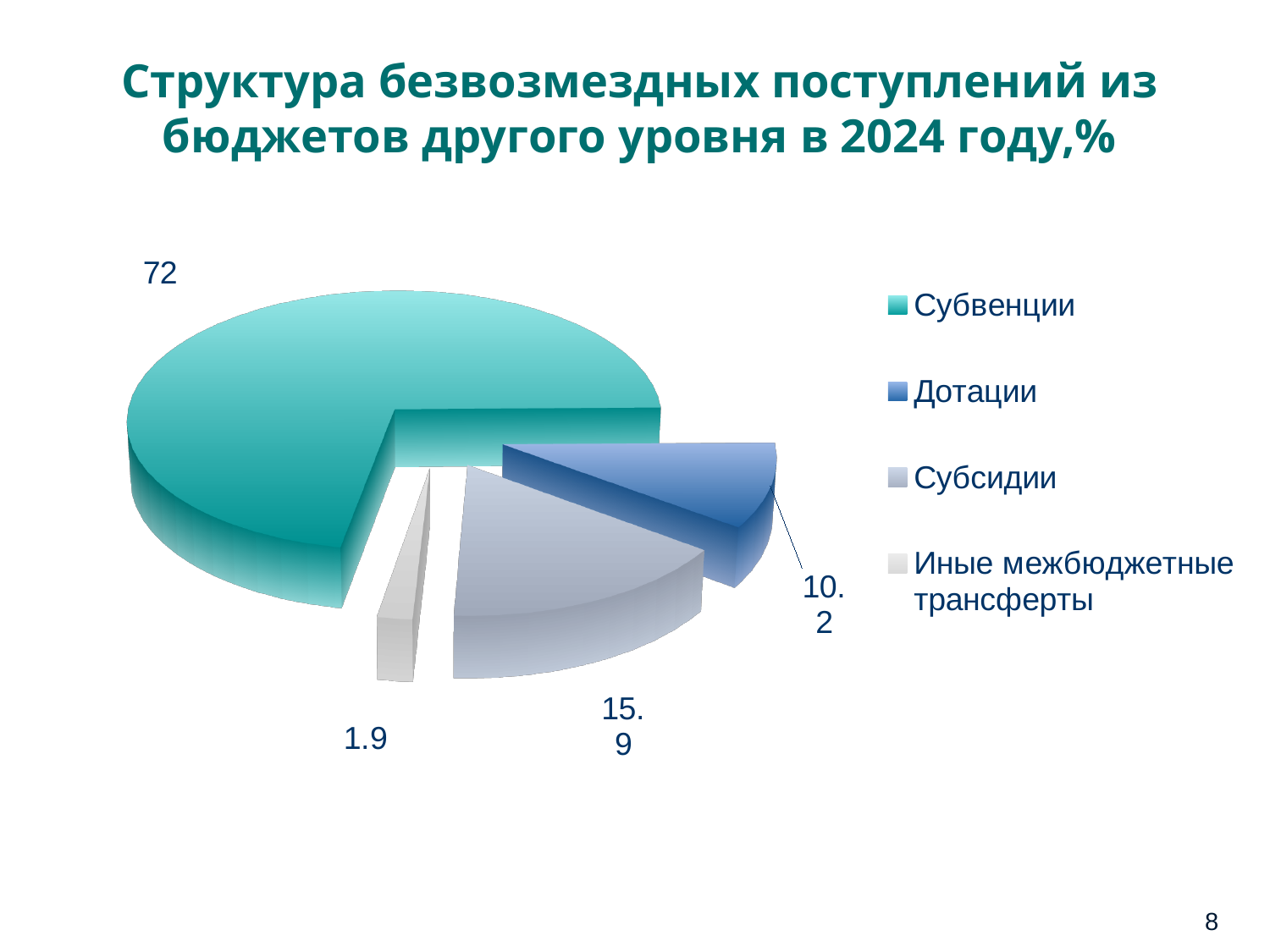
Which category has the largest slice? Субвенции Which category has the smallest slice? Иные межбюджетные трансферты How many slices does the pie chart have? 4 What is the value for Субсидии? 15.9 What is the value for Иные межбюджетные трансферты? 1.9 What is the title of the chart? Структура безвозмездных поступлений из бюджетов другого уровня в 2024 году,% What is the value for Дотации? 10.2 Which is larger, the value for Дотации or the value for Субсидии? Субсидии What is the value for Субвенции? 72 How many entries does the legend list? 4 What is the difference between the values for Субсидии and Дотации? 5.7 What kind of chart is shown on the slide? pie chart